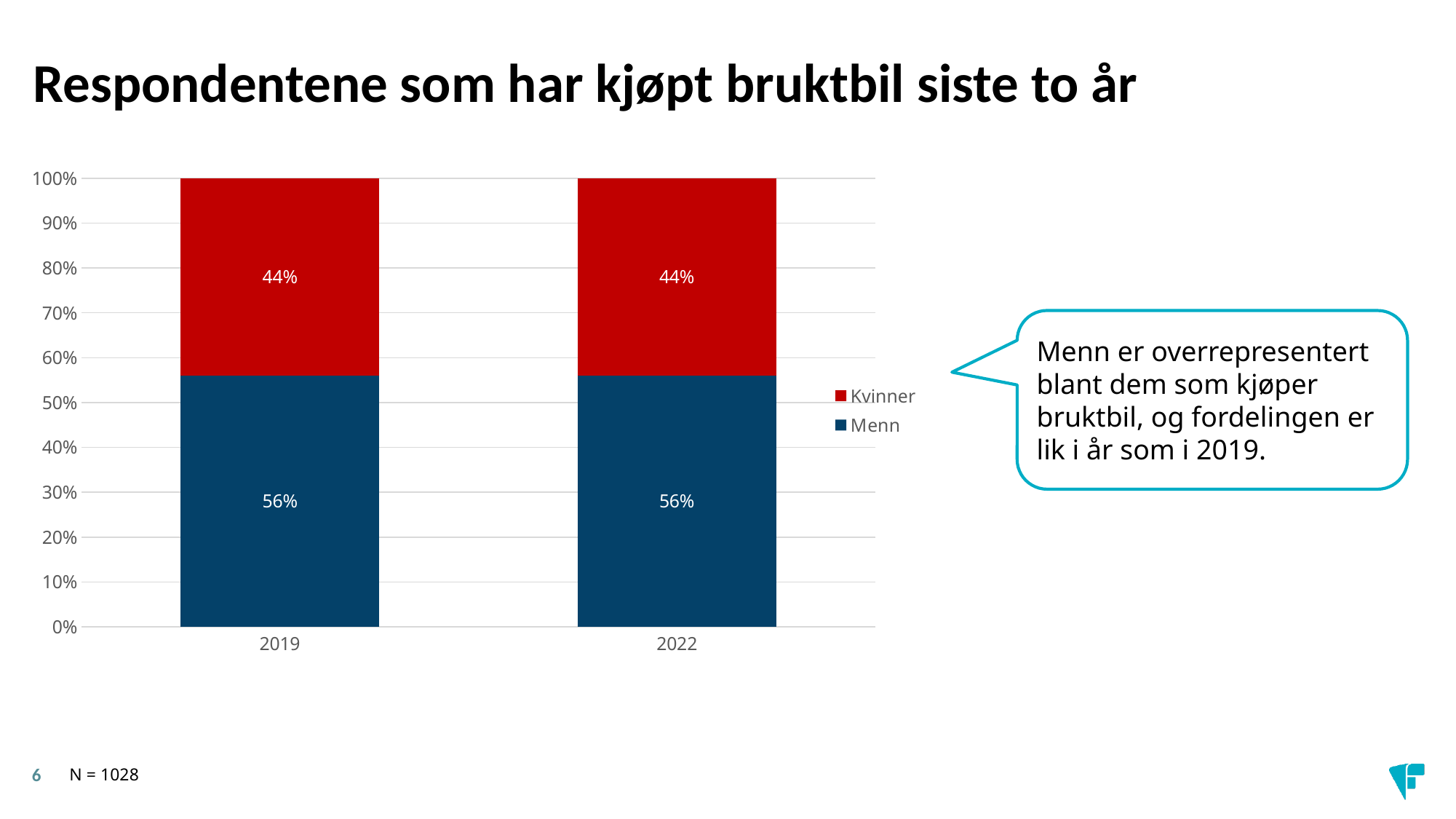
What is the difference between the Menn and Kvinner values in 2019? 12% What is the value for Menn in 2022? 56% What is the total of the stacked bar for 2022? 100% Which colour represents Kvinner in the chart? Red What is the value for Kvinner in 2019? 44% Which series has the larger value in 2022, Kvinner or Menn? Menn How many series does the legend list? 2 Does the value for Menn rise, fall or stay the same from 2019 to 2022? Stays the same What is the value for Menn in 2019? 56% How many categories are shown on the x axis? 2 What kind of chart is shown on the slide? Stacked bar chart What is the value for Kvinner in 2022? 44%